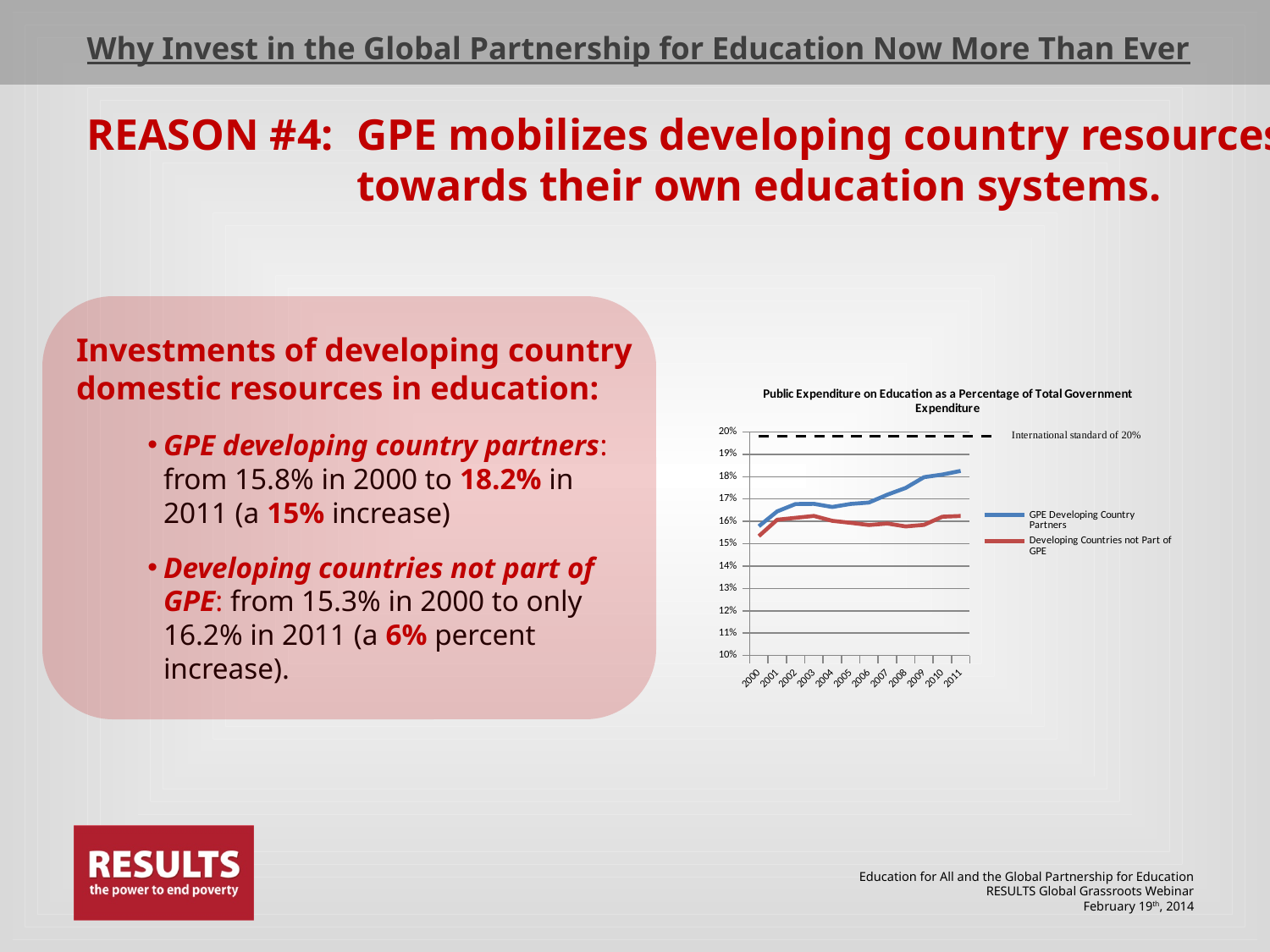
According to the slide, what value did GPE developing country partners reach in 2011? 18.2% How many years are shown along the x axis of the chart? 12 How many series does the chart legend list? 2 Is the value for GPE Developing Country Partners in 2000 greater or less than 17%? less What is the title of the chart? Public Expenditure on Education as a Percentage of Total Government Expenditure What does the dashed horizontal line at the top of the chart represent? International standard of 20% In 2011, which series is higher: GPE Developing Country Partners or Developing Countries not Part of GPE? GPE Developing Country Partners Is the value for GPE Developing Country Partners in 2011 greater or less than 18%? greater Is the GPE Developing Country Partners line above or below the dashed international standard line in 2011? below What kind of chart is shown on the slide? line chart Is the value for Developing Countries not Part of GPE in 2011 greater or less than 17%? less Does the GPE Developing Country Partners line rise or fall from 2000 to 2011? rise